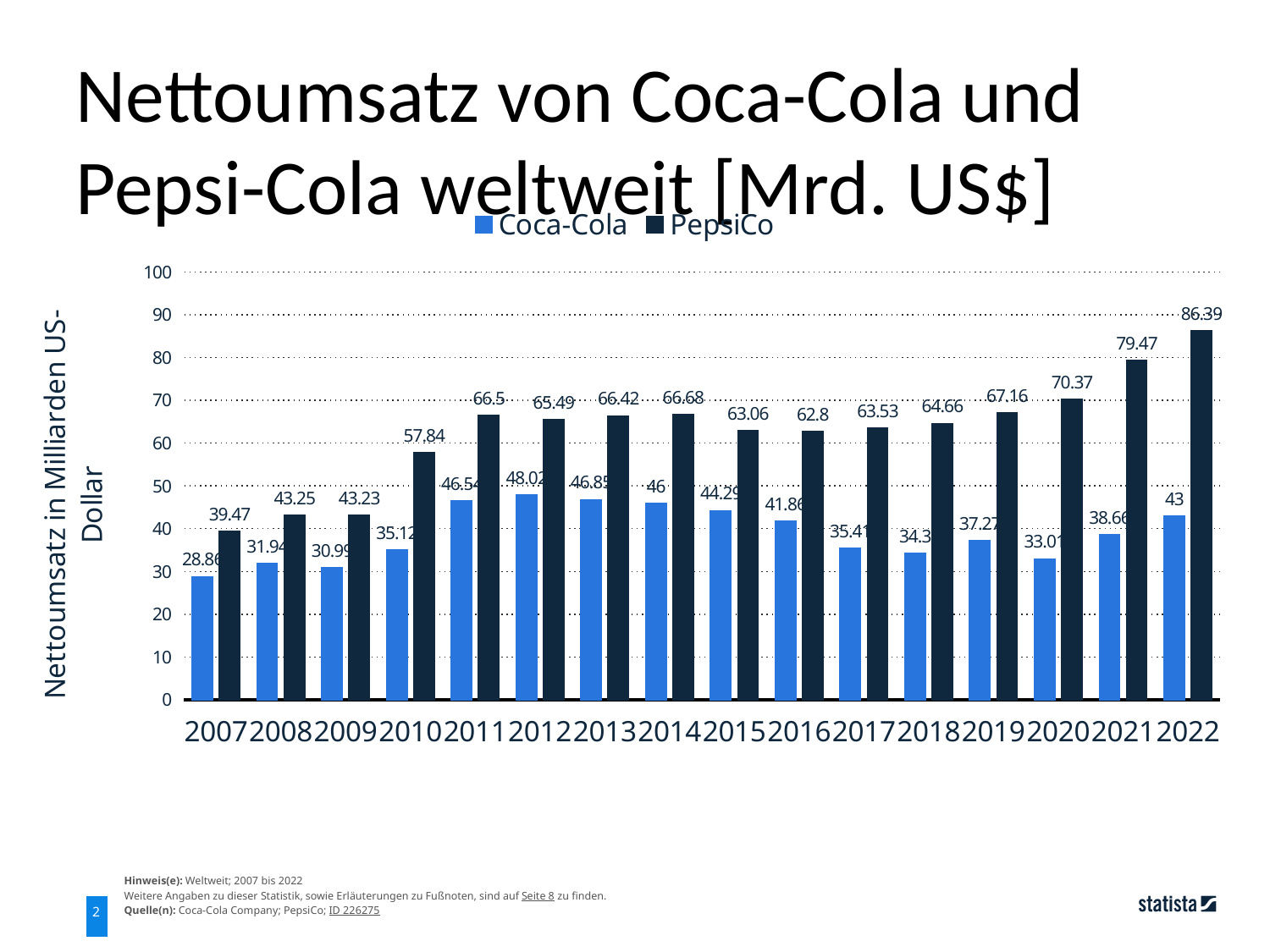
In which year was PepsiCo's net revenue highest? 2022 In which year was PepsiCo's net revenue lowest? 2007 What was PepsiCo's net revenue in 2022? 86.39 What kind of chart is shown on the slide? bar chart How many series does the legend list? 2 In which year was Coca-Cola's net revenue highest? 2012 What was PepsiCo's net revenue in 2010? 57.84 What is the difference between PepsiCo's and Coca-Cola's net revenue in 2022? 43.39 Which company had the higher net revenue in 2010, Coca-Cola or PepsiCo? PepsiCo Is the value for Coca-Cola in 2007 greater or less than 30? less How many years are shown on the x axis? 16 What was Coca-Cola's net revenue in 2008? 31.94